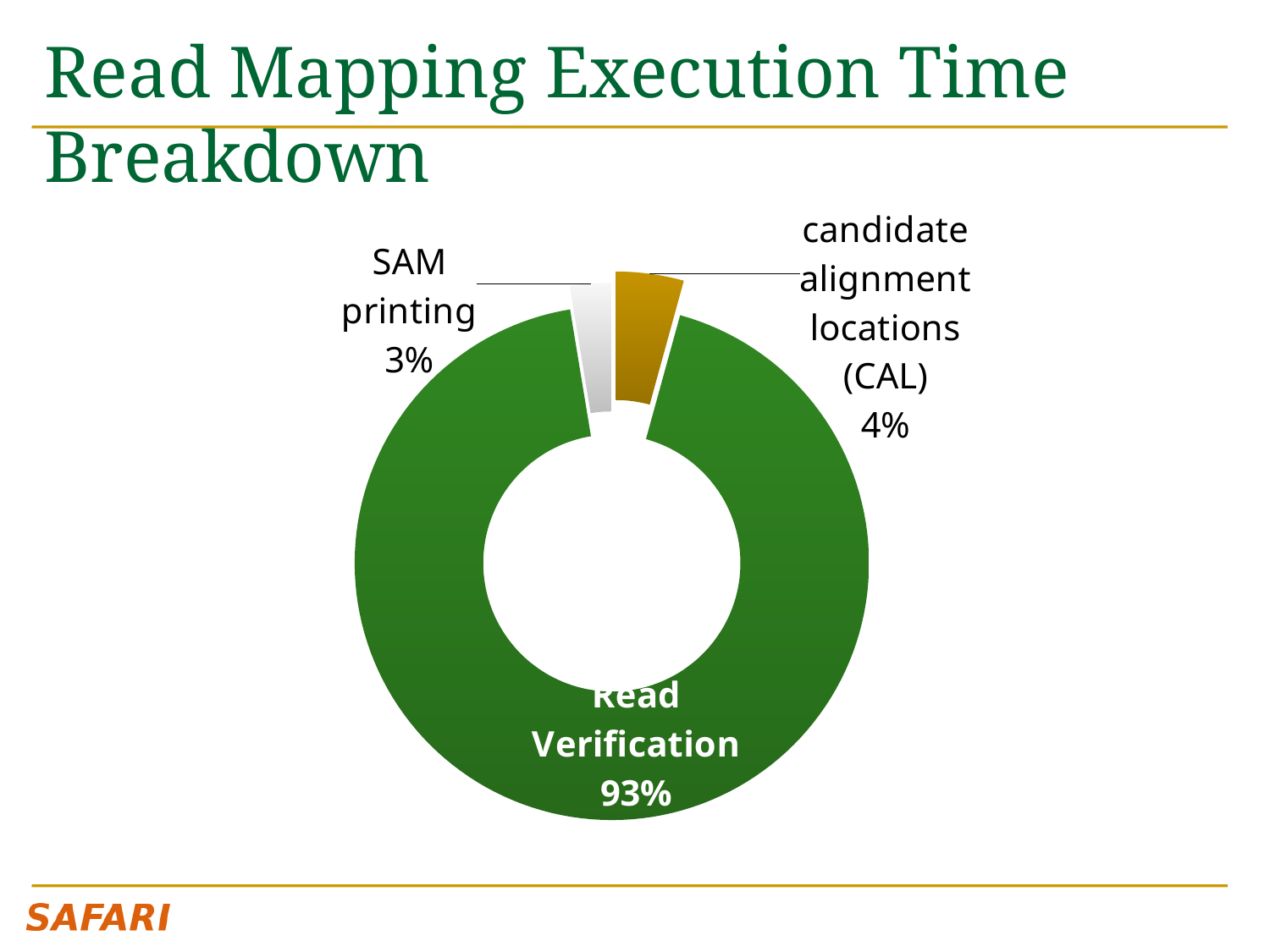
What colour is the Read Verification segment? Green What is the difference in percentage points between candidate alignment locations (CAL) and SAM printing? 1 What is the difference in percentage points between Read Verification and candidate alignment locations (CAL)? 89 Which takes a larger share of execution time, SAM printing or candidate alignment locations (CAL)? candidate alignment locations (CAL) What kind of chart is shown on the slide? Doughnut (pie) chart Which stage takes the smallest share of read mapping execution time? SAM printing What share of execution time is taken by SAM printing? 3% What share of read mapping execution time is taken by Read Verification? 93% What is the title of the slide? Read Mapping Execution Time Breakdown What share of execution time is taken by candidate alignment locations (CAL)? 4% How many stages are shown in the chart? 3 Which stage takes the largest share of read mapping execution time? Read Verification